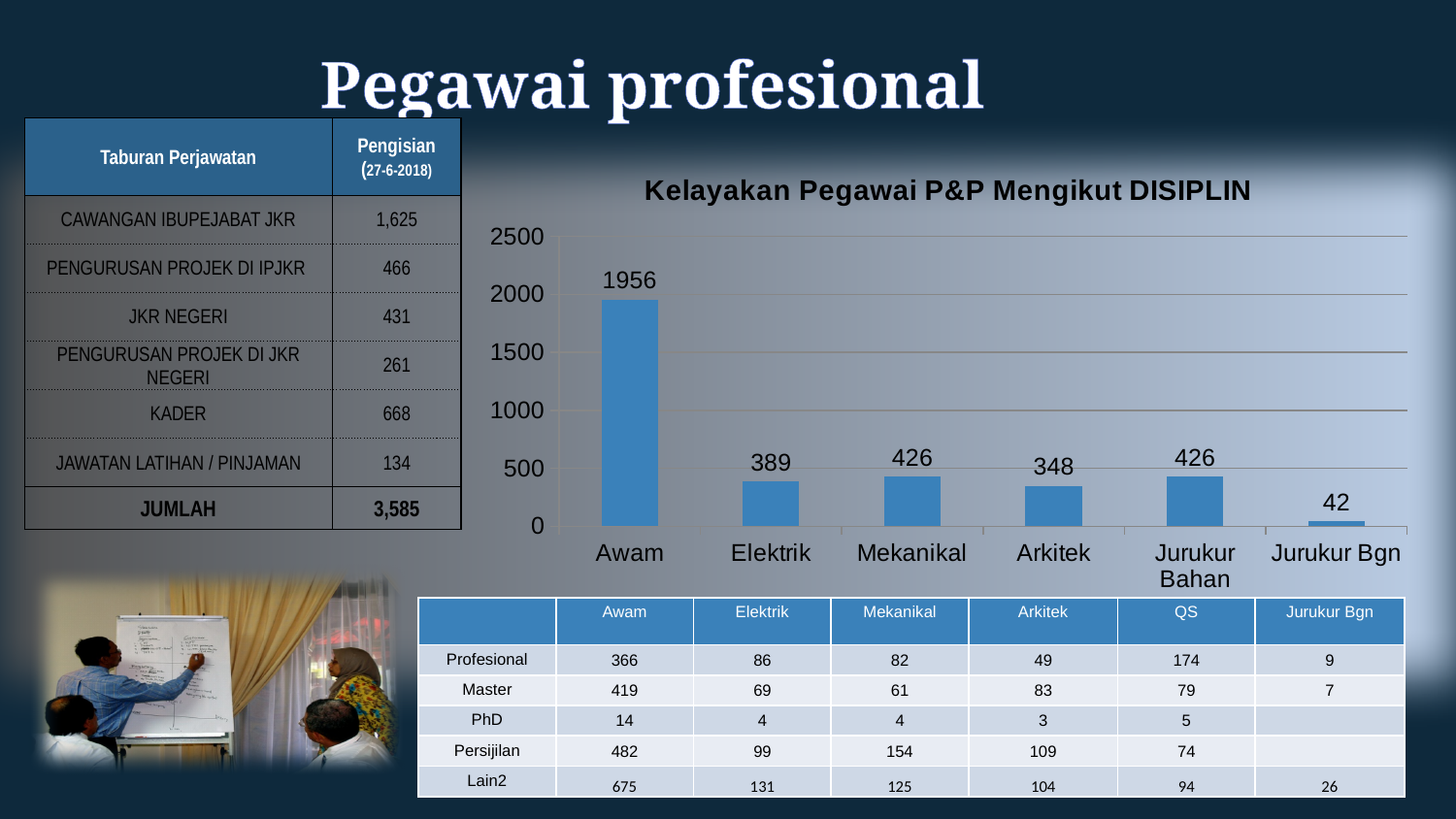
What is the value for Elektrik in the chart? 389 What type of chart is shown on the slide? bar chart What is the value for Arkitek in the chart? 348 What is the difference between the values for Mekanikal and Arkitek? 78 What is the value for Jurukur Bgn in the chart? 42 What is the difference between the values for Awam and Elektrik? 1567 Which is larger, the value for Elektrik or the value for Arkitek? Elektrik How many categories are shown on the x axis of the chart? 6 Which category has the highest value in the chart? Awam What is the value for Awam in the chart? 1956 Which category has the lowest value in the chart? Jurukur Bgn Is the value for Awam greater or less than 1500? greater